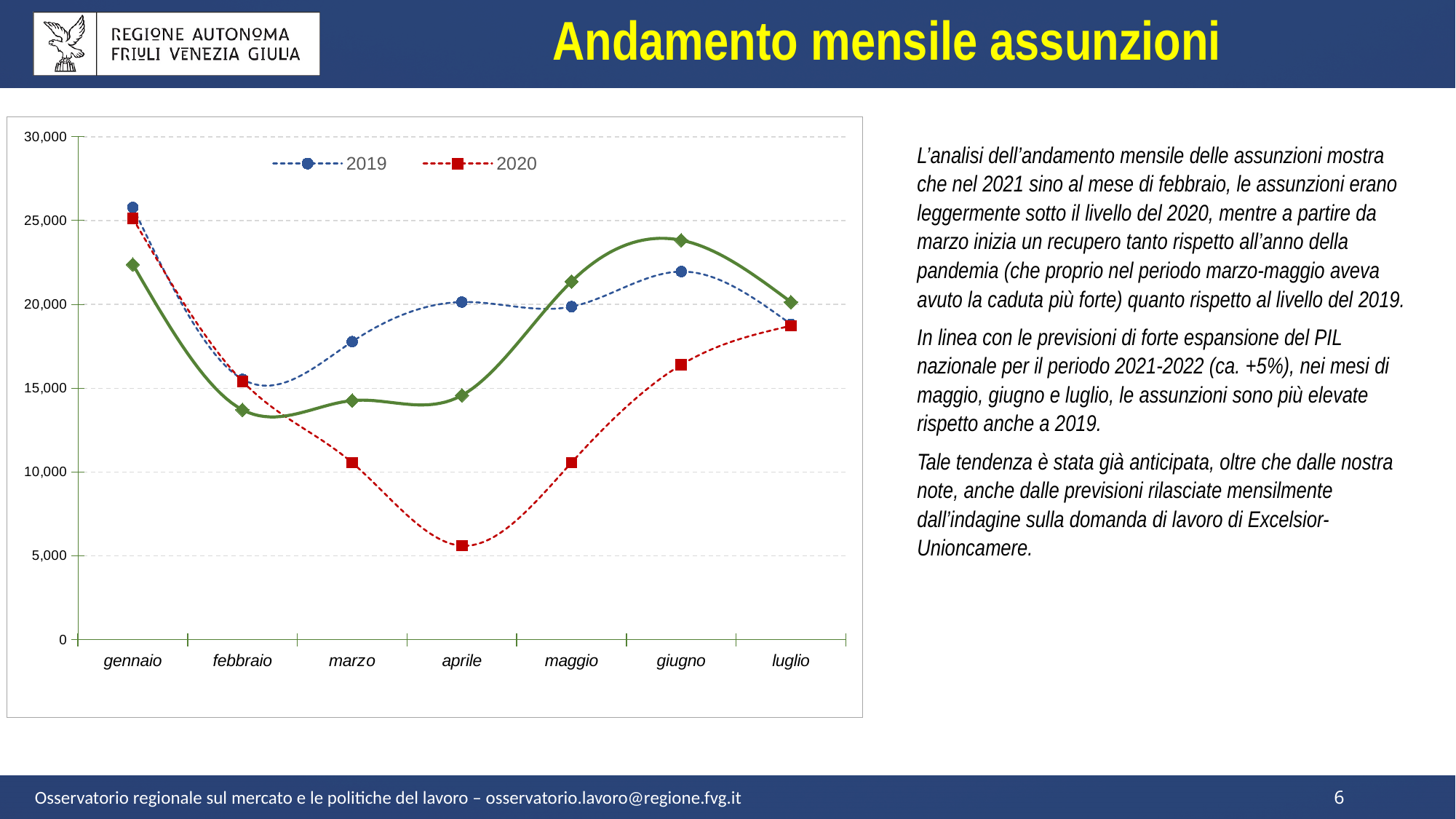
How many series does the chart legend list? 2 Is the value for 2020 in aprile greater or less than 10,000? less Does the 2020 series rise or fall from gennaio to aprile? fall How many months are shown on the x axis of the chart? 7 In which month does the 2020 series reach its lowest value? aprile Is the value for 2020 in giugno greater or less than 15,000? greater In marzo, which series has the larger value, 2019 or 2020? 2019 What colour is the 2020 series in the chart legend? red In which month does the 2020 series reach its highest value? gennaio What kind of chart is shown on the slide? line chart Is the value for 2019 in gennaio greater or less than 25,000? greater In which month does the 2019 series reach its highest value? gennaio